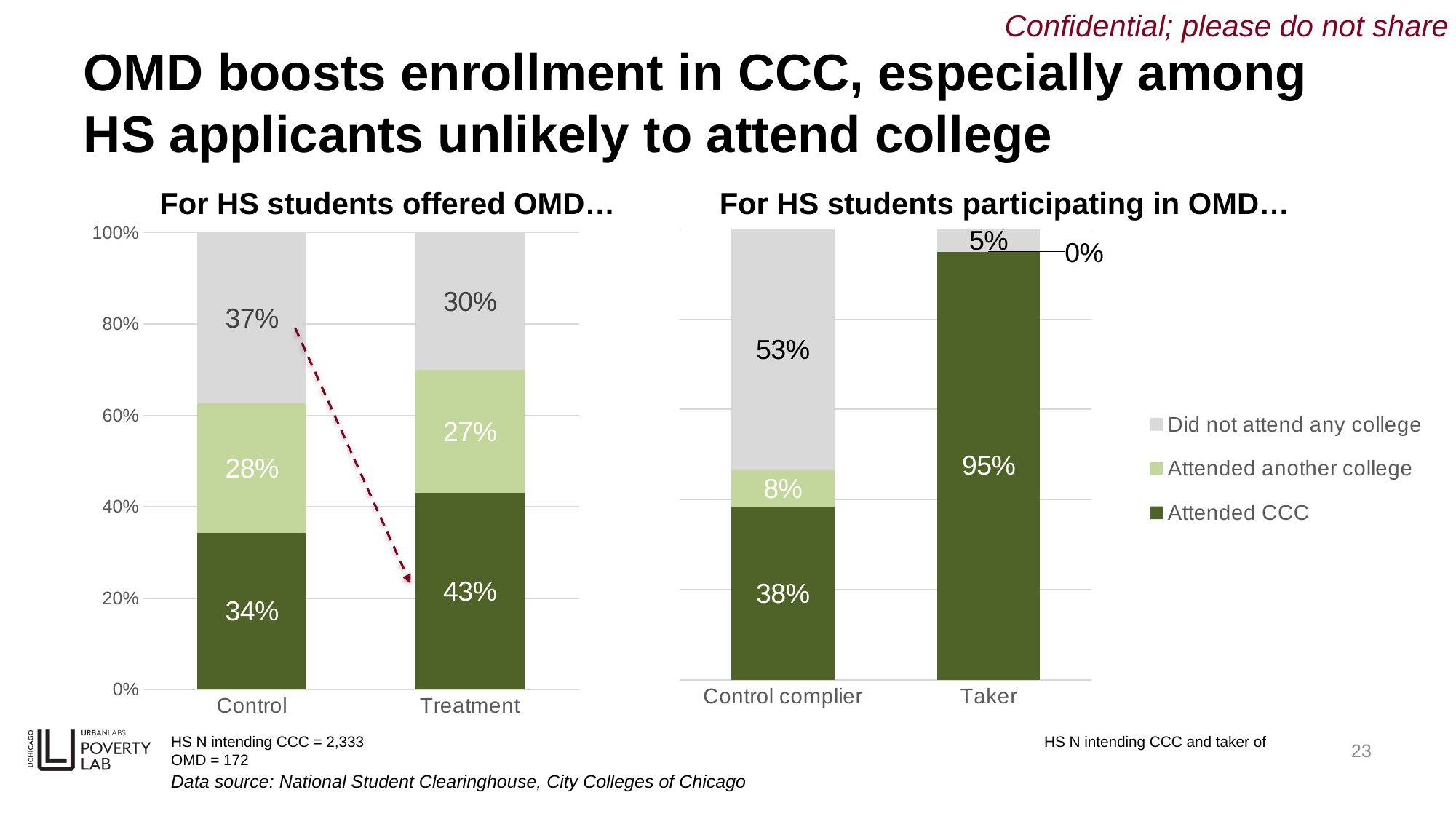
In the chart titled "For HS students offered OMD…", what percentage of the Treatment group attended CCC? 43% In the chart titled "For HS students participating in OMD…", what percentage of Control compliers attended another college? 8% Which legend entry is shown in the darkest green colour? Attended CCC What kind of chart is the chart titled "For HS students participating in OMD…"? Stacked bar chart In the chart titled "For HS students offered OMD…", what is the difference in the Attended CCC share between Treatment and Control? 9 percentage points In the chart titled "For HS students offered OMD…", what percentage of the Control group did not attend any college? 37% In the chart titled "For HS students participating in OMD…", what is the difference between the Did not attend any college shares of Control complier and Taker? 48 percentage points How many series does the legend list for the charts on this slide? 3 In the chart titled "For HS students offered OMD…", which group has the larger Did not attend any college share, Control or Treatment? Control In the chart titled "For HS students participating in OMD…", which category has the higher Attended CCC share, Control complier or Taker? Taker How many categories are shown on the x axis of the chart titled "For HS students offered OMD…"? 2 In the chart titled "For HS students participating in OMD…", what percentage of Takers attended CCC? 95%